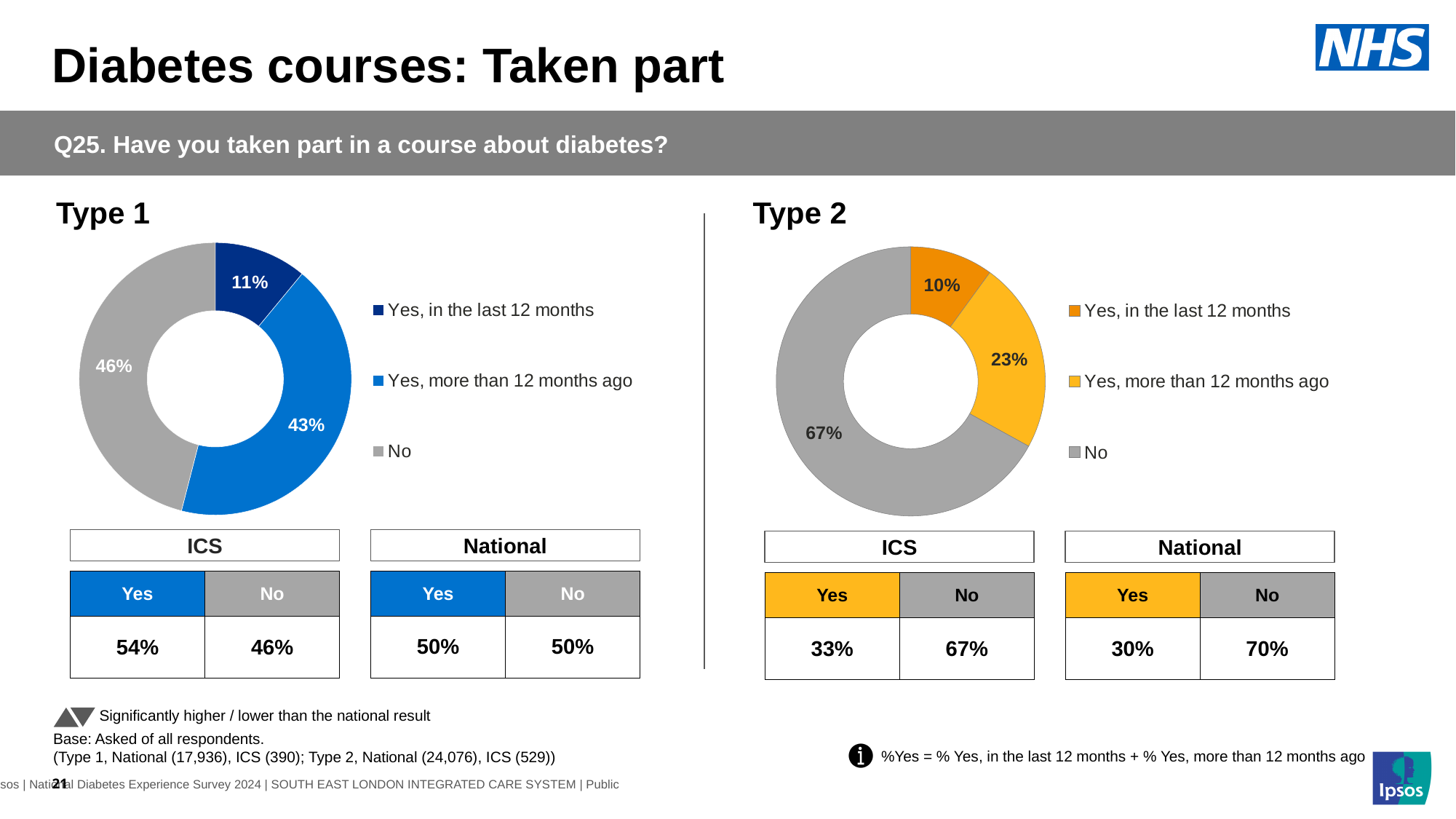
In the Type 2 chart, what is the difference in percentage points between 'Yes, more than 12 months ago' and 'Yes, in the last 12 months'? 13 In the Type 1 chart, what is the difference in percentage points between 'No' and 'Yes, more than 12 months ago'? 3 What kind of chart is used for Type 1? Doughnut (pie) chart How many categories does the Type 2 chart show? 3 In the Type 1 chart, which category has the largest share? No In the Type 2 chart, what percentage of respondents answered 'Yes, more than 12 months ago'? 23% What colour represents 'Yes, in the last 12 months' in the Type 2 chart? Orange Which is larger: the 'No' share in the Type 1 chart or the 'No' share in the Type 2 chart? Type 2 In the Type 2 chart, what percentage of respondents answered 'No'? 67% In the Type 1 chart, what percentage of respondents answered 'Yes, in the last 12 months'? 11% In the Type 2 chart, which category has the smallest share? Yes, in the last 12 months In the Type 1 chart, what percentage of respondents answered 'Yes, more than 12 months ago'? 43%